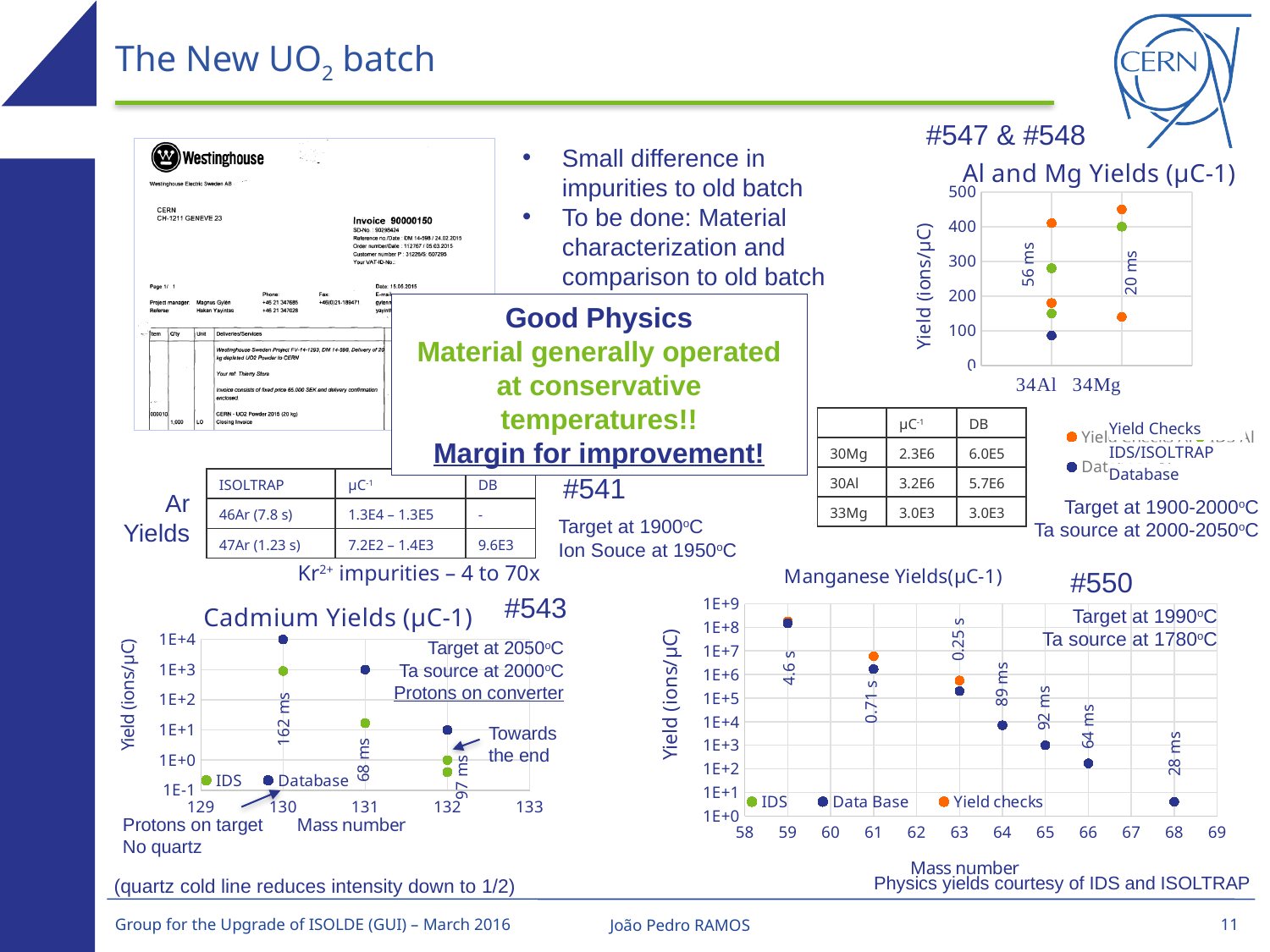
How many series does the legend of the "Manganese Yields(µC-1)" chart list? 3 In the "Manganese Yields(µC-1)" chart, do the yields rise or fall as mass number increases? fall In the "Manganese Yields(µC-1)" chart, at which mass number is the highest yield plotted? 59 In the "Cadmium Yields (µC-1)" chart, is the Database value at mass number 130 greater or less than 1E+3? greater What is the label of the y axis of the "Al and Mg Yields (µC-1)" chart? Yield (ions/µC) In the "Manganese Yields(µC-1)" chart, is the Data Base value at mass number 68 greater or less than 1E+2? less How many series does the legend of the "Cadmium Yields (µC-1)" chart list? 2 In the "Cadmium Yields (µC-1)" chart, at mass number 130, which series has the larger value, IDS or Database? Database What kind of chart is the "Cadmium Yields (µC-1)" chart? scatter chart In the "Manganese Yields(µC-1)" chart, what are the legend entries? IDS, Data Base, Yield checks In the "Manganese Yields(µC-1)" chart, at which mass number is the lowest yield plotted? 68 In the "Al and Mg Yields (µC-1)" chart, is the highest point for 34Mg greater or less than 400? greater